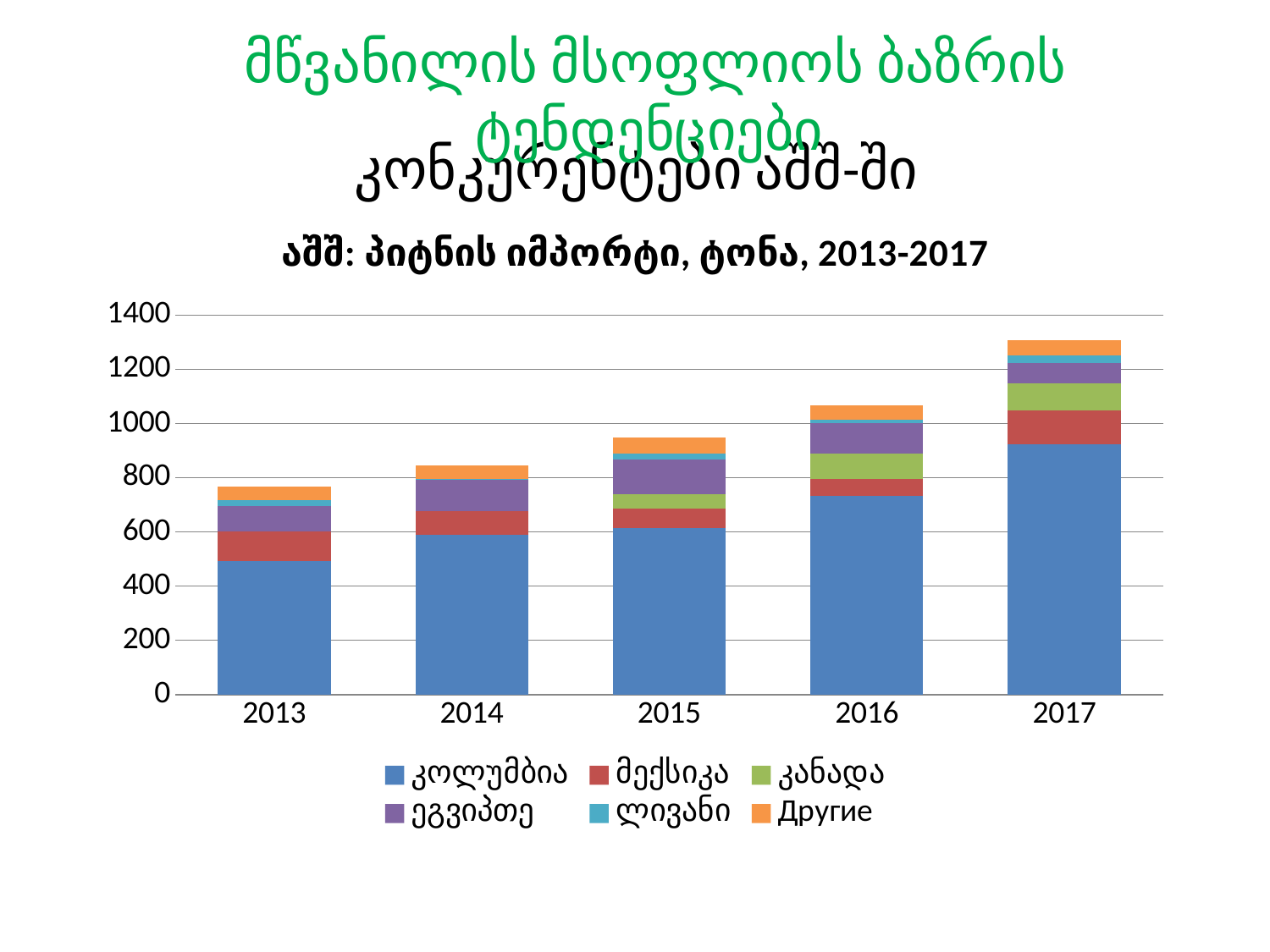
What is the title of the chart? აშშ: პიტნის იმპორტი, ტონა, 2013-2017 Do the total bar heights rise or fall from 2013 to 2017? rise Is the total bar for 2016 greater or less than 1000? greater Which is larger, the total bar for 2015 or the total bar for 2014? 2015 Is the კოლუმბია segment for 2017 greater or less than 800? greater Which year has the highest total bar in the chart? 2017 Is the total bar for 2013 greater or less than 800? less How many series does the chart legend list? 6 How many years are shown on the x axis of the chart? 5 Which year has the lowest total bar in the chart? 2013 What kind of chart is shown on the slide? stacked bar chart